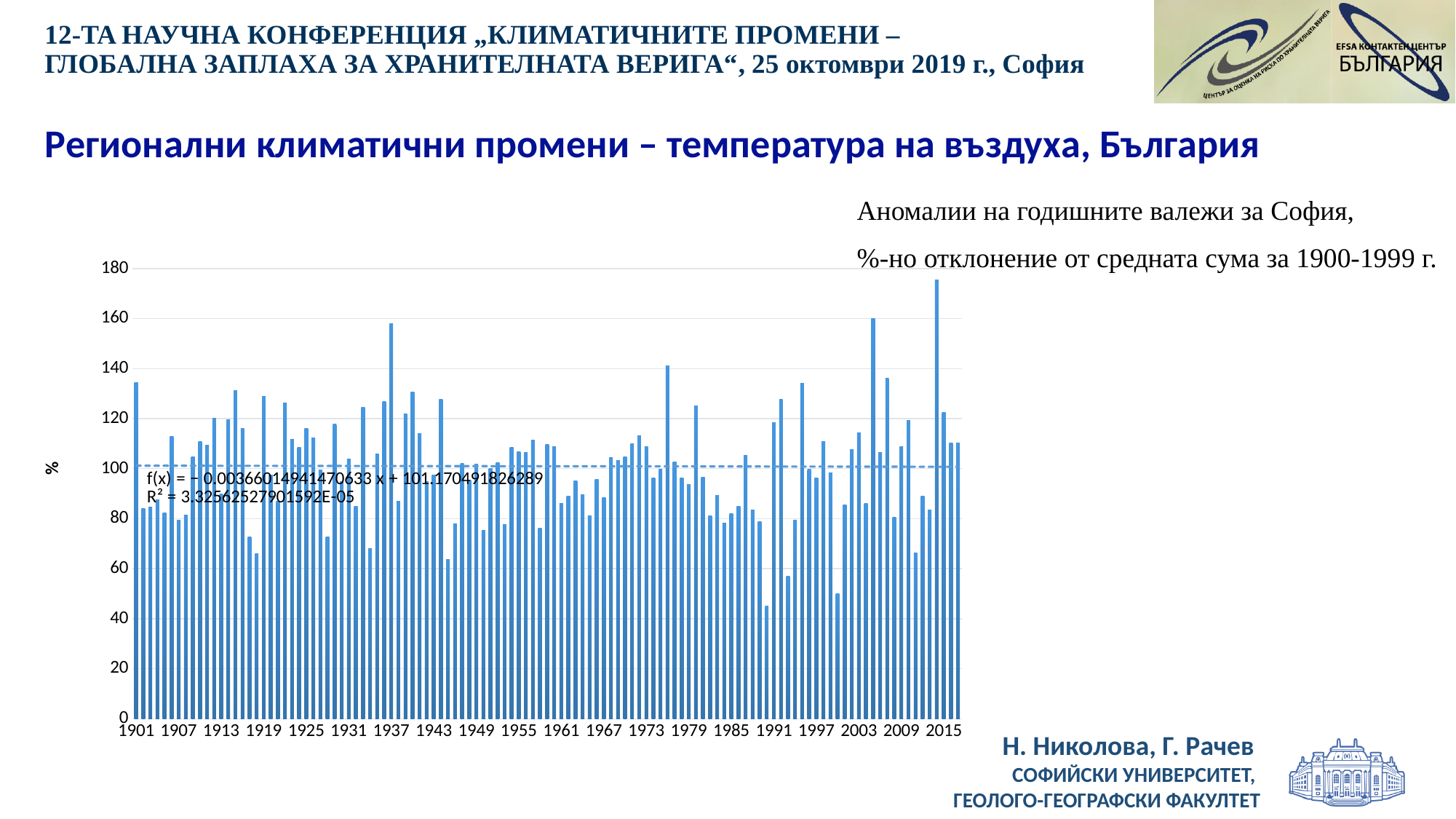
Is the value for 1985 greater or less than 100? less Is the value for 2003 greater or less than 100? greater What is the label on the vertical axis of the chart? % Is the value for 1961 greater or less than 100? less What kind of chart is shown on the slide? bar chart What is the highest tick value shown on the vertical axis? 180 Which year has the larger value, 1937 or 1943? 1937 Which year has the larger value, 1901 or 1907? 1901